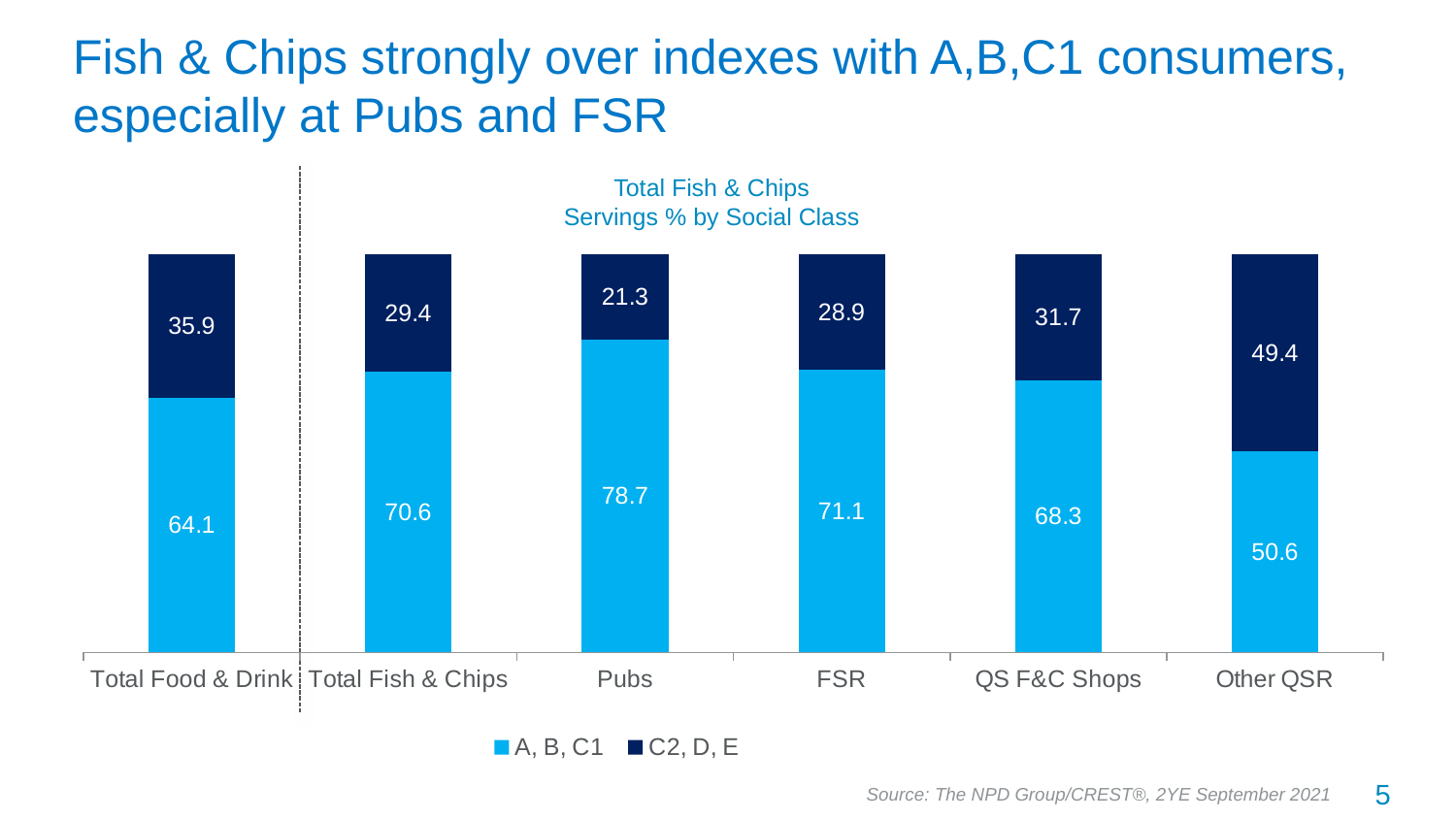
What kind of chart is shown on the slide? Stacked bar chart Which category has the highest A, B, C1 value? Pubs What is the A, B, C1 value for Pubs? 78.7 What is the A, B, C1 value for Total Food & Drink? 64.1 How many categories are shown on the x axis? 6 How many series does the legend list? 2 Which category has the lowest A, B, C1 value? Other QSR Which category has the lowest C2, D, E value? Pubs What is the C2, D, E value for Other QSR? 49.4 What is the difference between the A, B, C1 values for Pubs and Other QSR? 28.1 What is the total of the stacked bar for Total Fish & Chips? 100 Which has the larger A, B, C1 value, FSR or QS F&C Shops? FSR